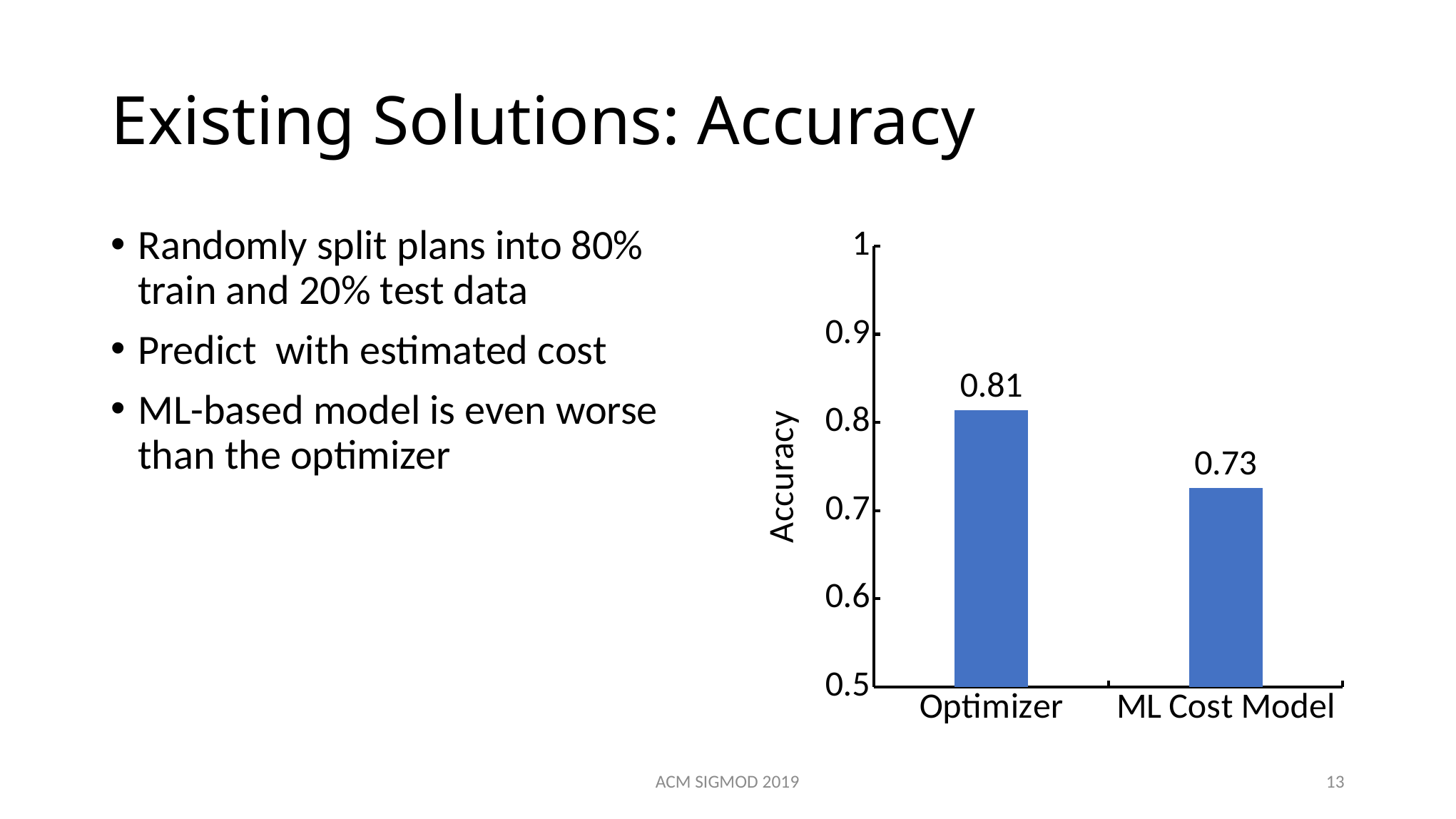
What is the label of the vertical axis of the chart? Accuracy What is the accuracy value for Optimizer? 0.81 What is the accuracy value for ML Cost Model? 0.73 Is the accuracy for ML Cost Model greater or less than 0.8? less What is the difference in accuracy between Optimizer and ML Cost Model? 0.08 Which category has the highest accuracy? Optimizer Which has a larger accuracy value, Optimizer or ML Cost Model? Optimizer Is the accuracy for Optimizer greater or less than 0.8? greater Which category has the lowest accuracy? ML Cost Model What kind of chart is shown on the slide? Bar chart What is the lowest value shown on the vertical axis of the chart? 0.5 How many categories are shown on the chart? 2